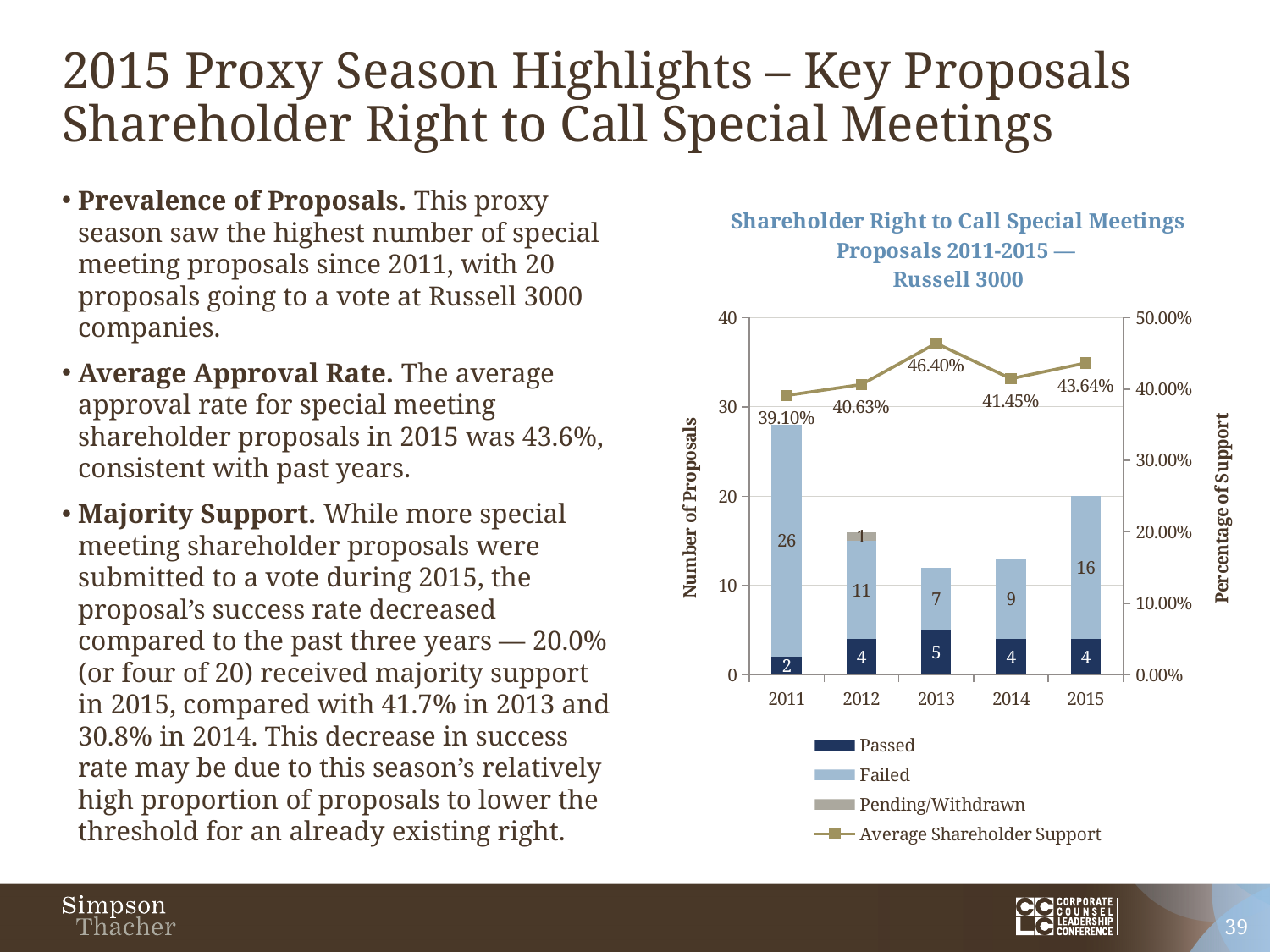
How many proposals failed in 2011? 26 How many series does the legend list? 4 What is the title of the chart? Shareholder Right to Call Special Meetings Proposals 2011-2015 — Russell 3000 In which year was Average Shareholder Support lowest? 2011 Which year had more failed proposals, 2014 or 2015? 2015 What is the total number of proposals shown in the stacked bar for 2011? 28 What was the Average Shareholder Support in 2013? 46.40% In which year was Average Shareholder Support highest? 2013 What is the total number of proposals shown in the stacked bar for 2012? 16 What is the difference between the number of failed proposals in 2015 and in 2012? 5 How many years are shown on the x axis? 5 How many proposals passed in 2013? 5